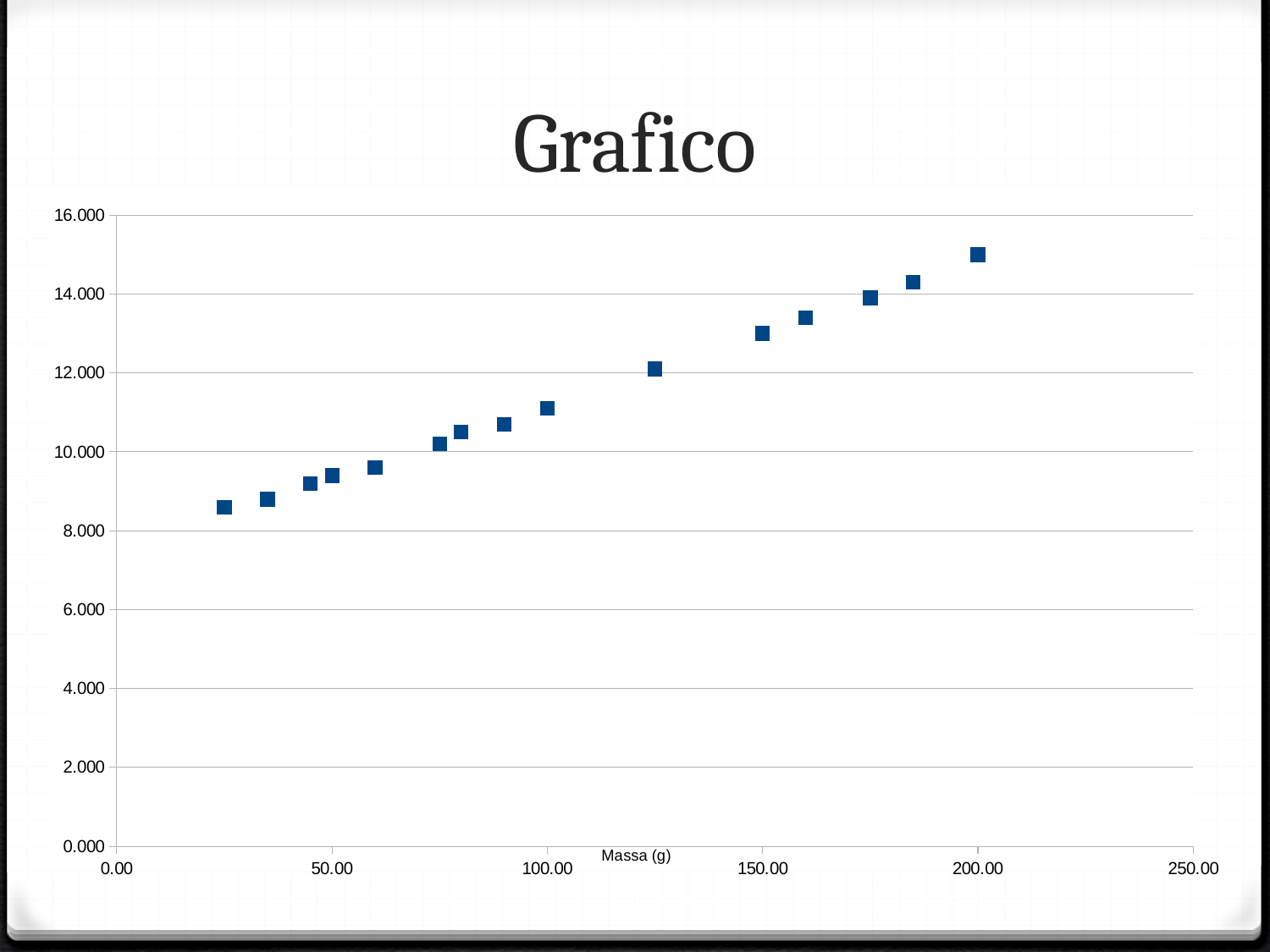
Is the value for the point at Massa 100.00 greater or less than 10.000? greater What is the title of the chart? Grafico What kind of chart is shown on the slide? Scatter chart At which Massa (g) value does the highest plotted point occur? 200.00 Is the value for the point at Massa 150.00 greater or less than 12.000? greater Is the value for the point at Massa 200.00 greater or less than 14.000? greater How many data points are plotted on the chart? 15 What is the label of the x axis? Massa (g) Do the plotted values rise or fall as Massa (g) increases along the x axis? Rise Which point has the highest value: the one at Massa 100.00 or the one at Massa 200.00? The one at Massa 200.00